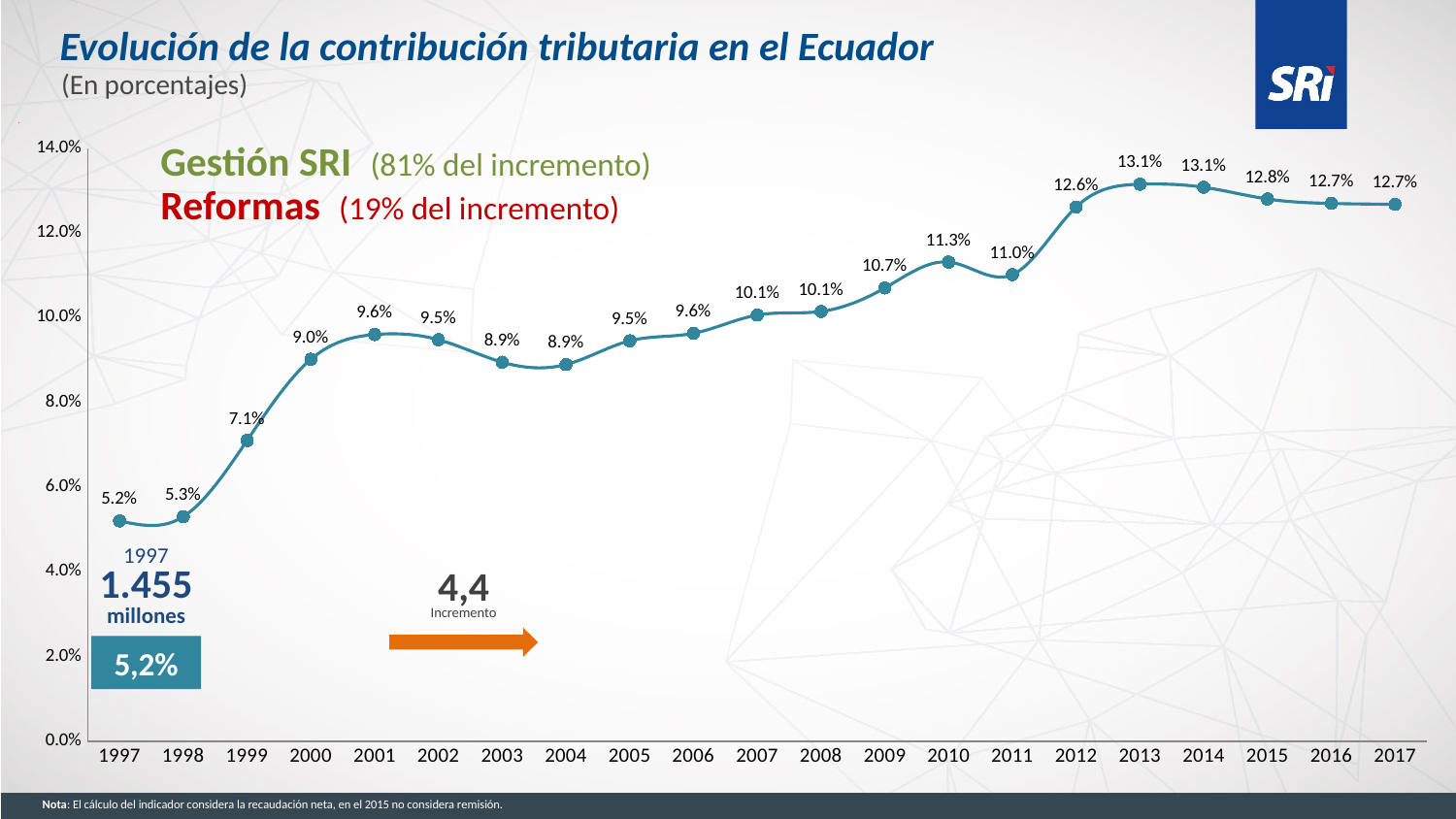
How many years are plotted on the chart? 21 What is the value for 2010? 11.3% What is the difference between the values for 2017 and 1997? 7.5% What is the title of the chart? Evolución de la contribución tributaria en el Ecuador Which year has the lowest value? 1997 What is the value for 2017? 12.7% Overall, do the values rise or fall from 1997 to 2017? rise What is the highest value shown on the chart? 13.1% Which is larger, the value for 2001 or the value for 2004? 2001 What is the value for 1997? 5.2% What is the value for 2003? 8.9% What type of chart is shown on the slide? line chart